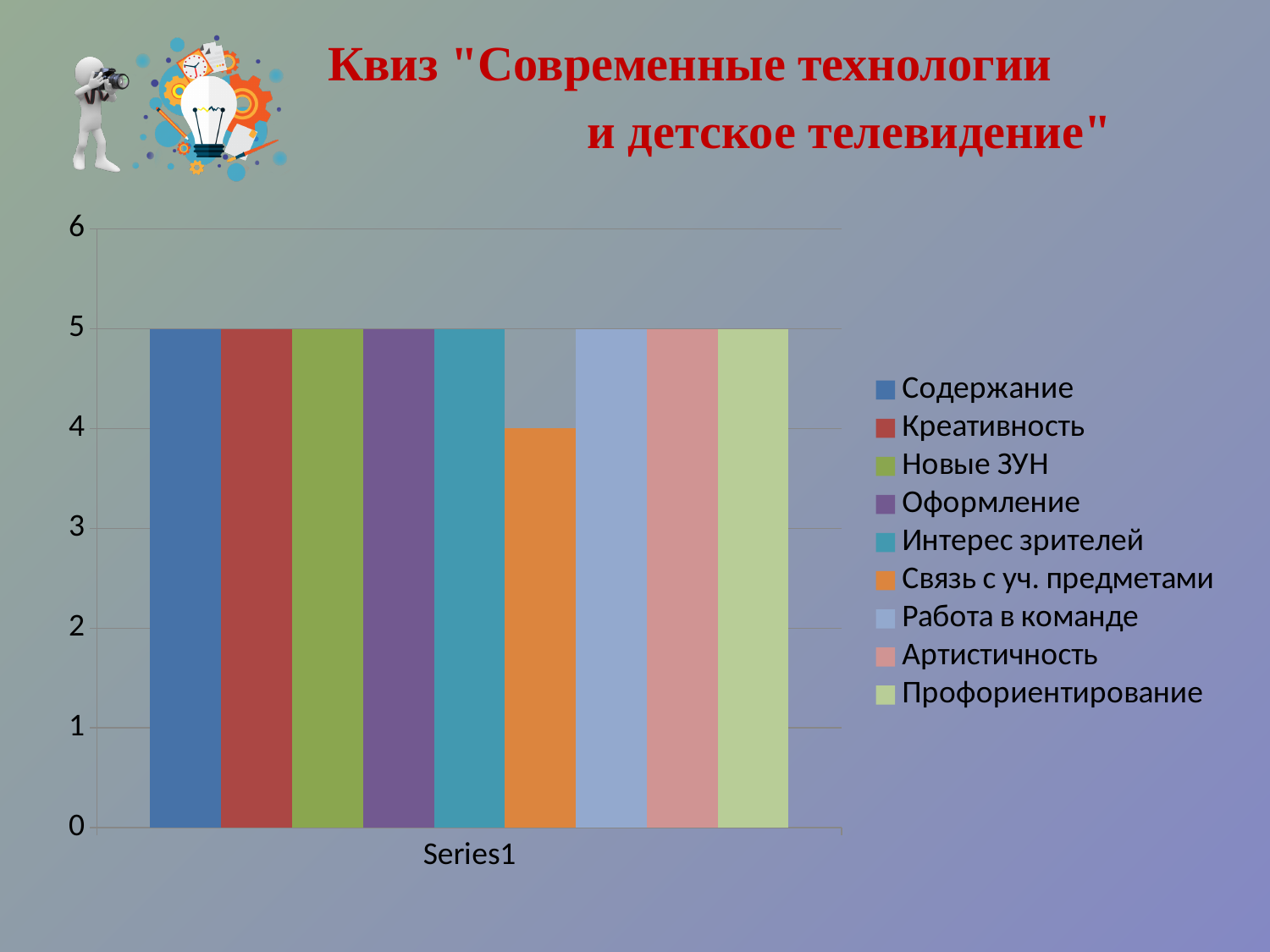
What is the value of the bar for Содержание? 5 What is the value of the bar for Связь с уч. предметами? 4 How many bars are plotted in the chart? 9 What is the difference between the bar for Креативность and the bar for Связь с уч. предметами? 1 What is the label shown on the horizontal axis below the bars? Series1 What is the value of the bar for Профориентирование? 5 Which is larger, the bar for Работа в команде or the bar for Связь с уч. предметами? Работа в команде Which legend entry has the lowest bar? Связь с уч. предметами Is the value for Артистичность greater or less than 3? greater What colour is the bar for Связь с уч. предметами? orange How many entries does the legend list? 9 What kind of chart is shown on the slide? bar chart